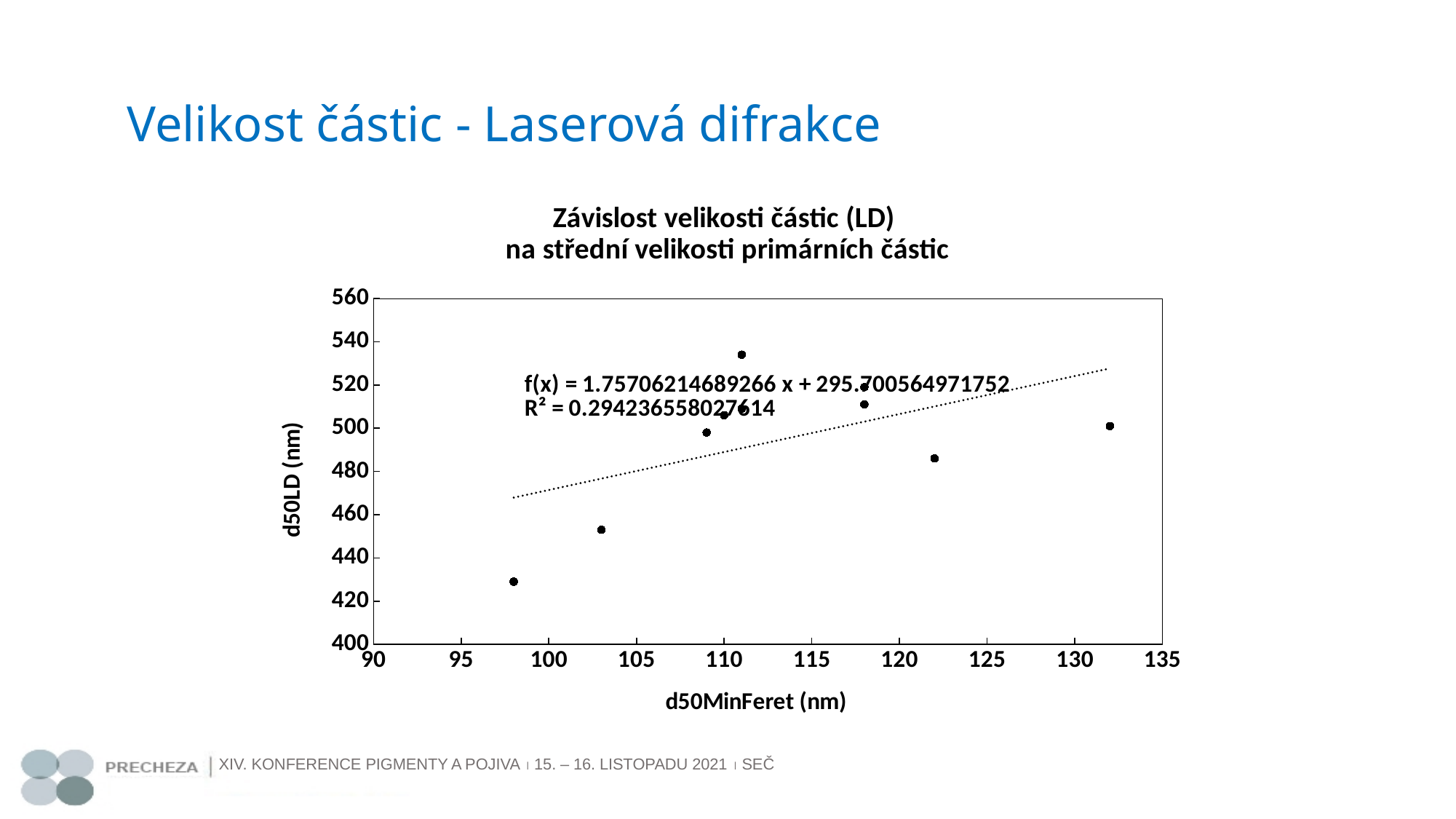
What is the R² value printed on the chart? 0.294236558027614 Does the dotted trendline rise or fall as d50MinFeret increases? rises Which point has the higher d50LD value: the one at d50MinFeret of about 118 nm or the one at about 122 nm? the one at about 118 nm Is the d50LD value for the point at d50MinFeret of about 132 nm greater or less than 480? greater Is the d50LD value for the point at d50MinFeret of about 103 nm greater or less than 460? less Is the d50LD value for the point at d50MinFeret of about 98 nm greater or less than 440? less What kind of chart is shown on the slide? scatter chart What is the label of the x axis? d50MinFeret (nm)